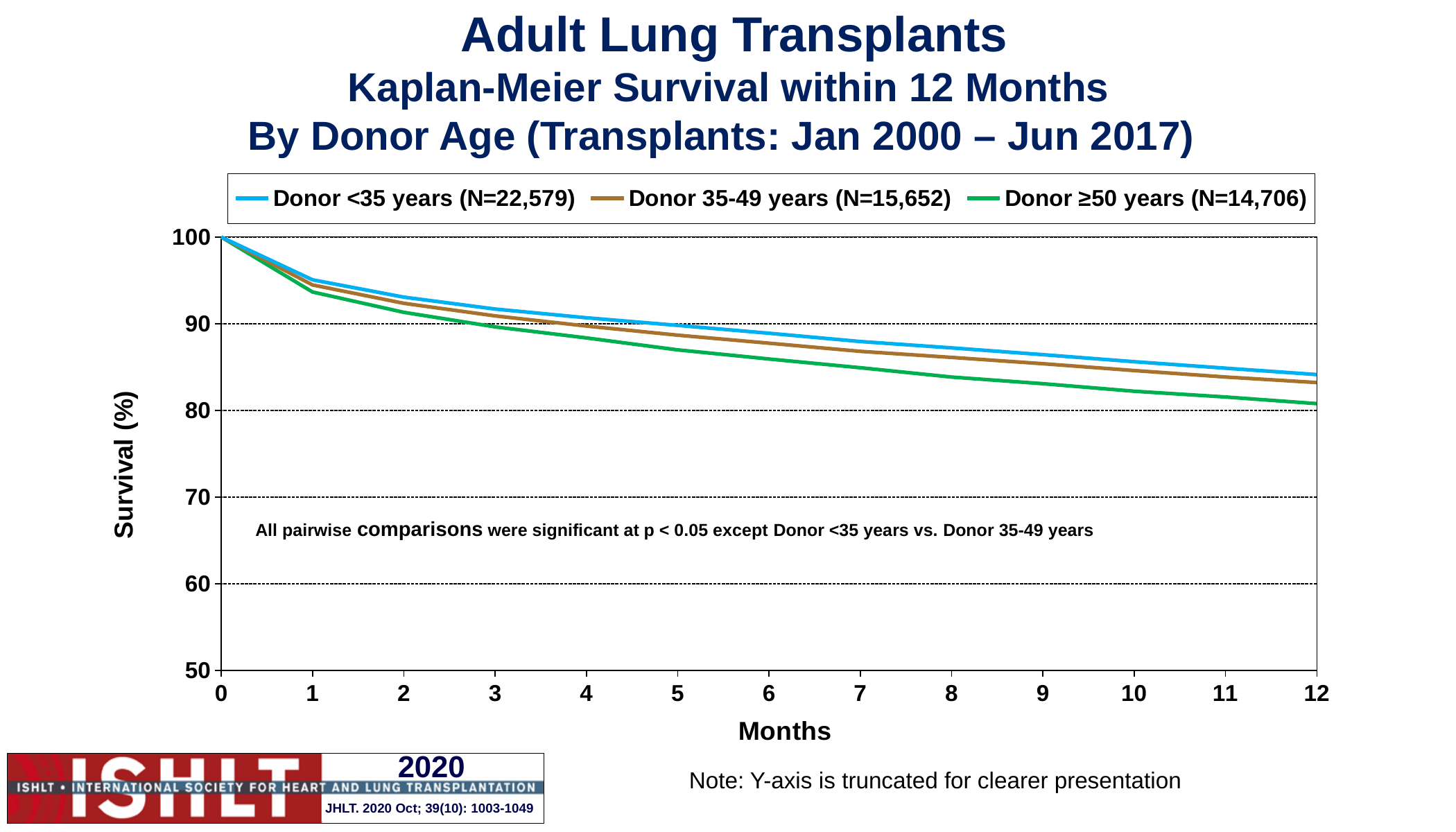
Is the survival for Donor ≥50 years at 5 months greater or less than 90? less Is the survival for Donor <35 years at 12 months greater or less than 80? greater What kind of chart is shown on the slide? line chart What is the survival (%) for all three donor age groups at month 0? 100 How many series does the legend list? 3 Is the survival for Donor <35 years at 1 month greater or less than 90? greater At 12 months, which group has higher survival: Donor <35 years or Donor ≥50 years? Donor <35 years Which donor age group has the lowest survival at 12 months? Donor ≥50 years What is the N for the Donor <35 years group shown in the legend? 22,579 What colour is the line for Donor ≥50 years? green Do the survival curves rise or fall as months increase? fall